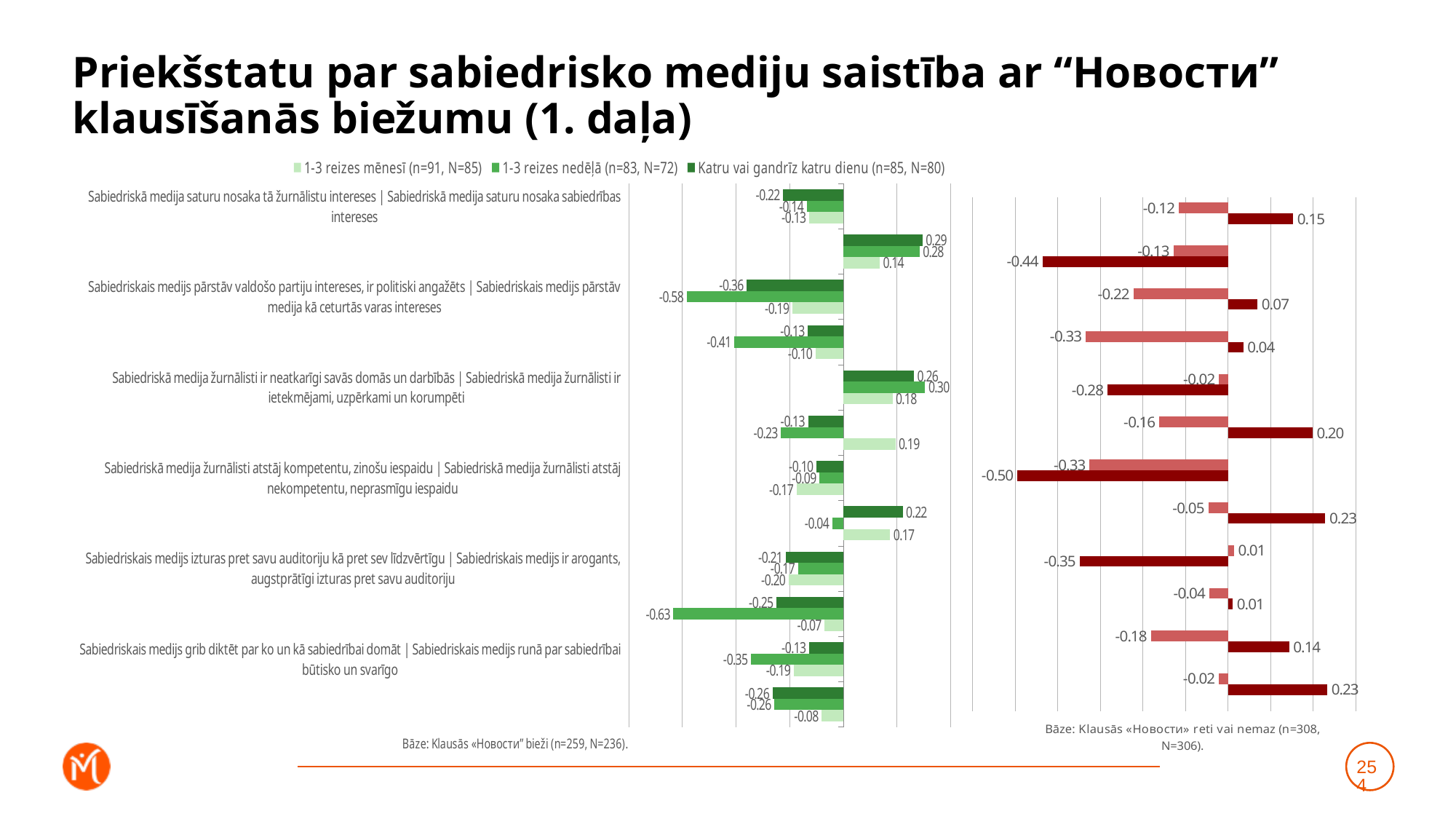
In the left (green) chart, what is the value of the topmost dark green bar? -0.22 In the left (green) chart, which series contains the lowest value, -0.63? 1-3 reizes nedēļā (n=83, N=72) In the right (red) chart, which is larger: the topmost dark red bar (0.15) or the bottommost dark red bar (0.23)? 0.23 In the left (green) chart, what is the highest value shown? 0.30 How many series does the legend of the left chart list? 3 In the right (red) chart, what is the lowest value shown? -0.50 In the left (green) chart, what is the difference between the highest value (0.30) and the lowest value (-0.63)? 0.93 What is the first series listed in the legend of the left chart? 1-3 reizes mēnesī (n=91, N=85) In the right (red) chart, what is the highest value shown? 0.23 In the left (green) chart, what is the lowest value shown? -0.63 What is the third series listed in the legend of the left chart? Katru vai gandrīz katru dienu (n=85, N=80) What kind of chart is the left chart on the slide? bar chart